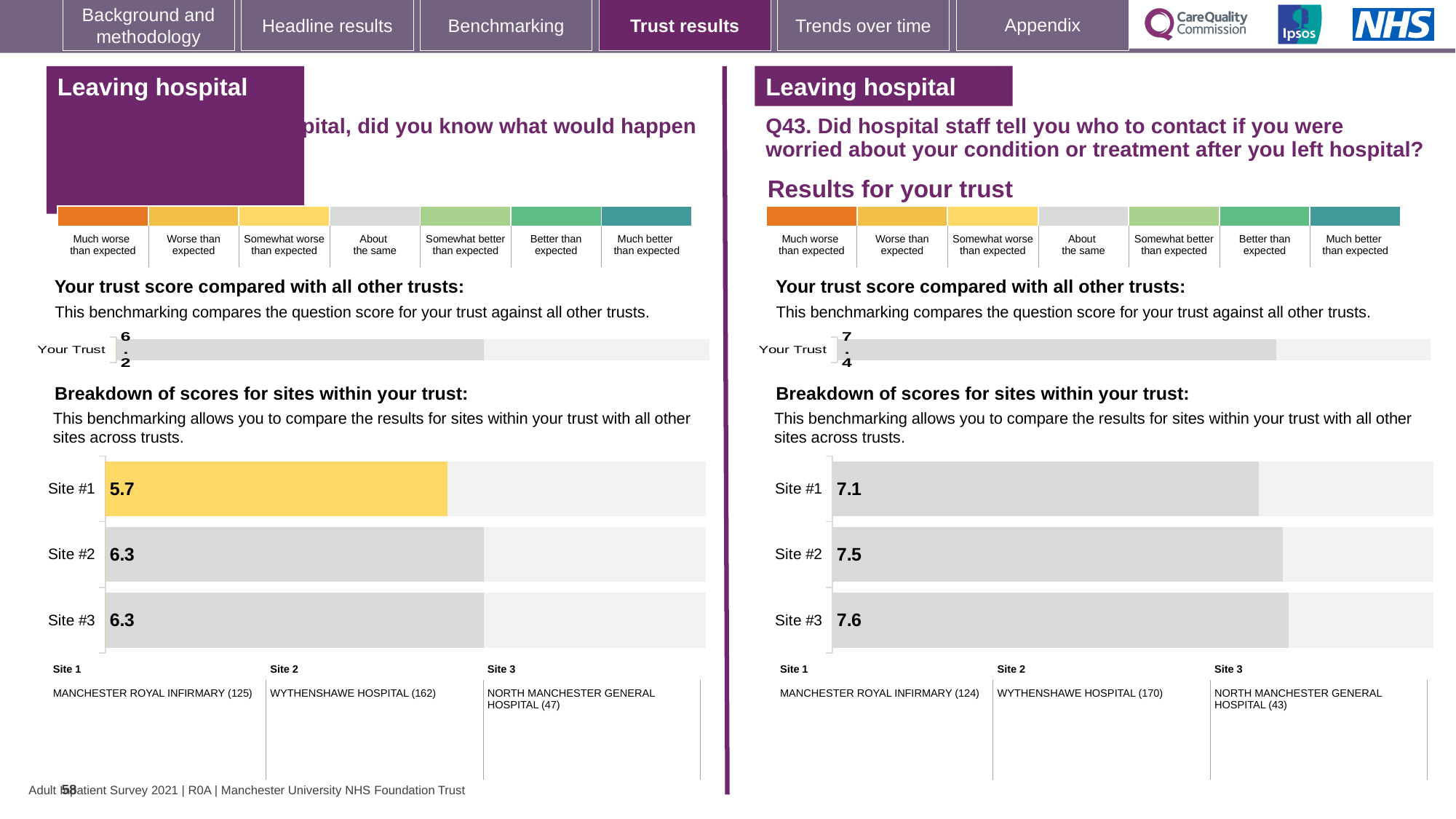
On the right-hand (Q43) site breakdown chart, what is the score for Site #3? 7.6 What type of chart is used for the site breakdown on the right-hand (Q43) side of the slide? Bar chart On the left-hand site breakdown chart, which site has the lowest score? Site #1 On the right-hand (Q43) site breakdown chart, which site has the highest score? Site #3 On the right-hand (Q43) site breakdown chart, what is the difference between the scores for Site #3 and Site #1? 0.5 On the right-hand (Q43) site breakdown chart, what is the score for Site #1? 7.1 On the left-hand site breakdown chart, what is the score for Site #2? 6.3 On the right-hand (Q43) 'Your trust score compared with all other trusts' chart, what is the score for Your Trust? 7.4 On the left-hand 'Your trust score compared with all other trusts' chart, what is the score for Your Trust? 6.2 On the left-hand site breakdown chart, what is the difference between the scores for Site #2 and Site #1? 0.6 On the left-hand site breakdown chart, what is the score for Site #1? 5.7 On the right-hand (Q43) site breakdown chart, how many sites are shown? 3